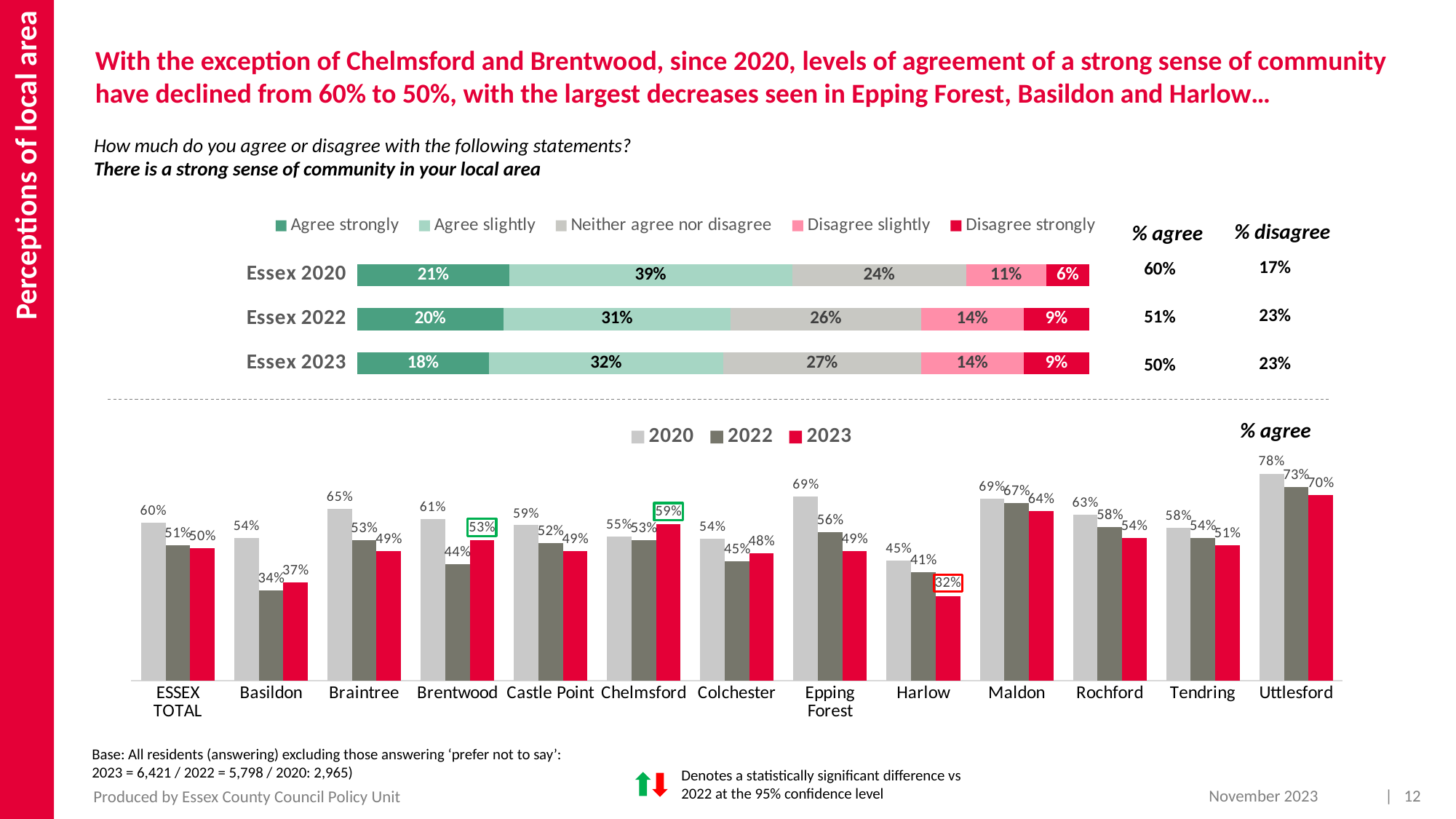
In the top stacked bar chart, which year has the highest 'Disagree slightly' share, Essex 2020 or Essex 2023? Essex 2023 In the top stacked bar chart, what is the difference between the 'Agree slightly' share for Essex 2020 and Essex 2022? 8% In the bottom bar chart, what is the difference between the 2020 and 2023 % agree values for Epping Forest? 20% In the top stacked bar chart, what percentage of Essex 2020 respondents agree strongly? 21% What type of chart is the bottom chart? Bar chart In the top stacked bar chart, how many series does the legend list? 5 In the bottom bar chart, which district has the highest 2020 % agree value? Uttlesford In the top stacked bar chart, what percentage of Essex 2023 respondents neither agree nor disagree? 27% In the bottom bar chart, how many series does the legend list? 3 In the bottom bar chart, which district has the lowest 2023 % agree value? Harlow In the bottom bar chart, what is the 2023 % agree value for Harlow? 32% In the bottom bar chart, how many categories are shown on the x axis? 13